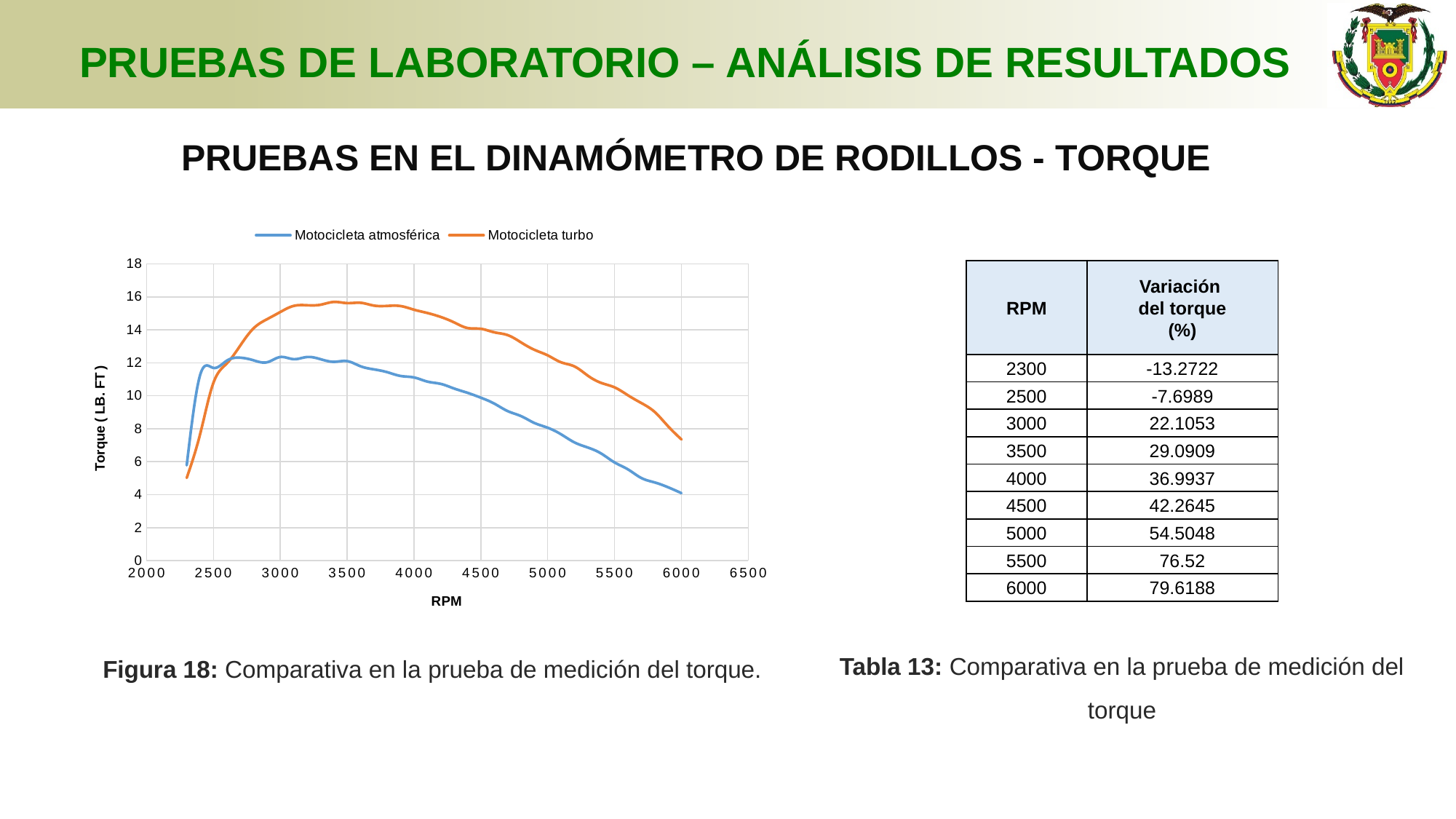
What is the label of the vertical axis of the torque chart? Torque ( LB. FT) In the torque chart, which series has the higher torque at 4000 RPM? Motocicleta turbo In the torque chart, does the Motocicleta turbo torque rise or fall between 2300 RPM and 3000 RPM? rise In the torque chart, is the value for Motocicleta turbo at 3500 RPM greater or less than 14? greater In the torque chart, does the Motocicleta atmosférica torque rise or fall between 3500 RPM and 6000 RPM? fall In the torque chart, is the value for Motocicleta turbo at 6000 RPM greater or less than 6? greater In the torque chart, is the value for Motocicleta atmosférica at 6000 RPM greater or less than 6? less What are the two series named in the legend of the torque chart? Motocicleta atmosférica and Motocicleta turbo In the torque chart, which series reaches the higher peak torque? Motocicleta turbo How many series does the legend of the torque chart list? 2 What kind of chart is shown in Figura 18? line chart